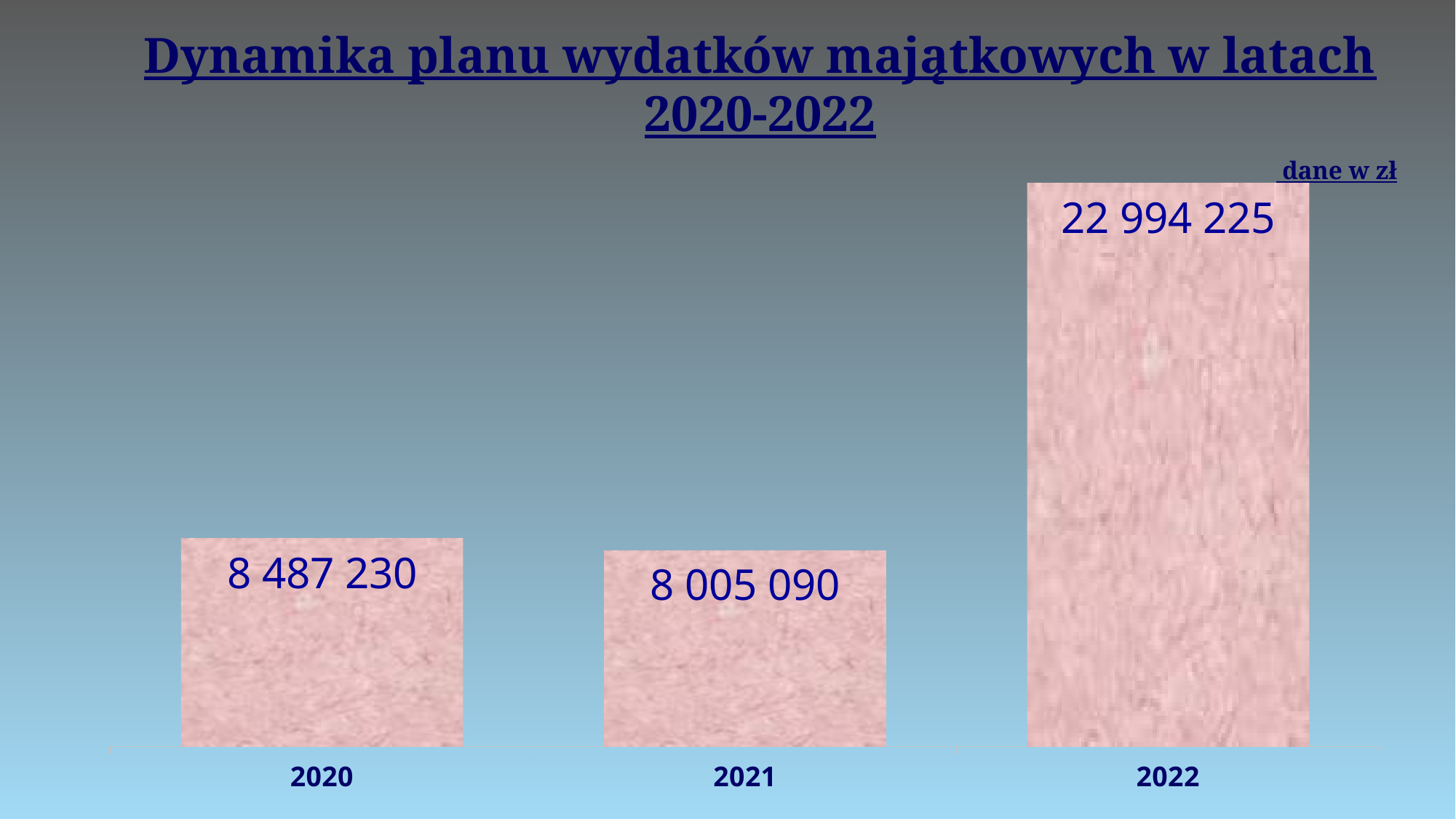
Does the value rise or fall from 2021 to 2022? rise What is the value for 2022? 22 994 225 What is the difference between the values for 2020 and 2021? 482 140 How many years are shown in the chart? 3 In what unit are the data given, according to the note on the slide? zł What is the value for 2020? 8 487 230 Which is larger, the value for 2020 or the value for 2021? 2020 Which year has the highest value? 2022 What kind of chart is shown on the slide? bar chart What is the difference between the values for 2022 and 2020? 14 506 995 Which year has the lowest value? 2021 What is the value for 2021? 8 005 090